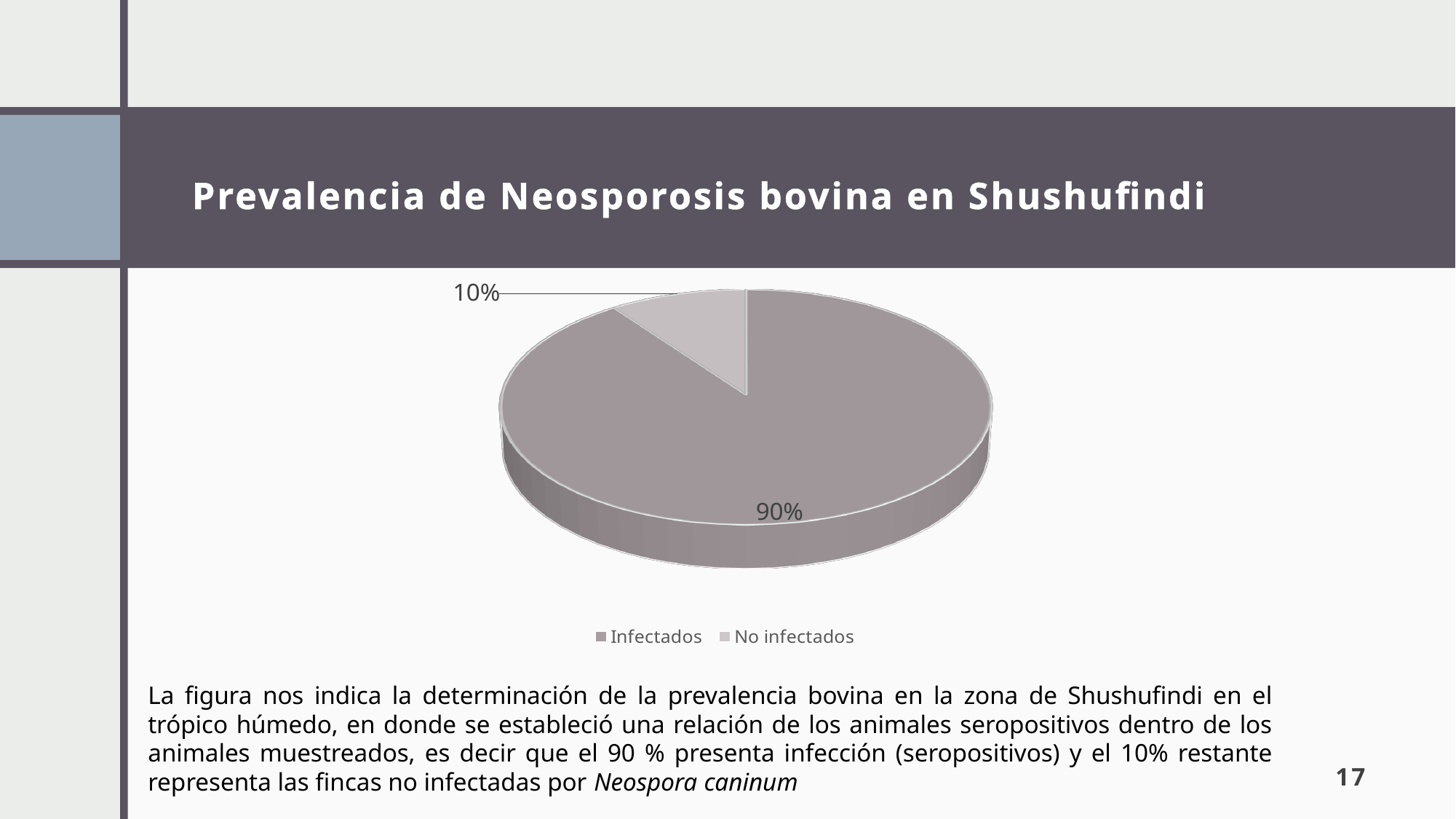
Which legend entry is shown in the lighter grey colour? No infectados What is the difference in percentage points between the Infectados and No infectados slices? 80 Which category has the largest slice of the pie? Infectados How many categories does the pie chart show? 2 What kind of chart is shown on the slide? Pie chart What share of the pie does the Infectados slice represent? 90% Which category has the smallest slice of the pie? No infectados What share of the pie does the No infectados slice represent? 10% How many entries does the legend list? 2 What is the title shown above the chart? Prevalencia de Neosporosis bovina en Shushufindi Which slice is larger, Infectados or No infectados? Infectados